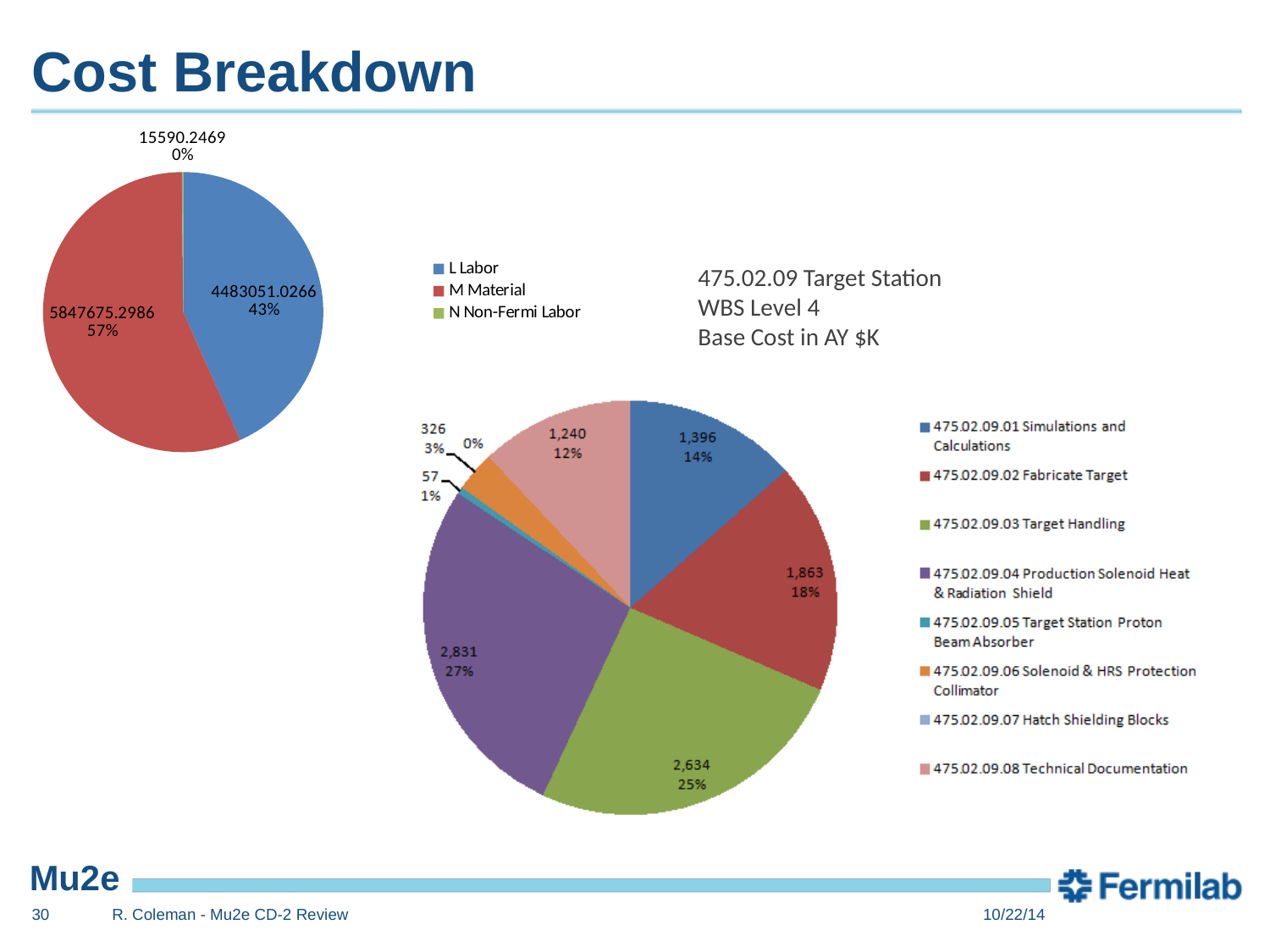
How many categories does the legend of the right pie chart (475.02.09 Target Station) list? 8 On the left pie chart, what percentage share does N Non-Fermi Labor have? 0% On the right pie chart (475.02.09 Target Station), what value is shown for 475.02.09.03 Target Handling? 2,634 On the right pie chart (475.02.09 Target Station), which category has the largest slice? 475.02.09.04 Production Solenoid Heat & Radiation Shield On the right pie chart (475.02.09 Target Station), what percentage share does 475.02.09.04 Production Solenoid Heat & Radiation Shield have? 27% On the left pie chart, which category has the largest slice? M Material On the left pie chart, what percentage share does L Labor have? 43% On the left pie chart, what value is shown for M Material? 5847675.2986 What type of chart is used for the 475.02.09 Target Station cost breakdown? Pie chart On the right pie chart (475.02.09 Target Station), what is the difference between the values for 475.02.09.02 Fabricate Target and 475.02.09.01 Simulations and Calculations? 467 On the right pie chart (475.02.09 Target Station), which is larger: 475.02.09.08 Technical Documentation or 475.02.09.06 Solenoid & HRS Protection Collimator? 475.02.09.08 Technical Documentation How many entries does the legend of the left pie chart list? 3